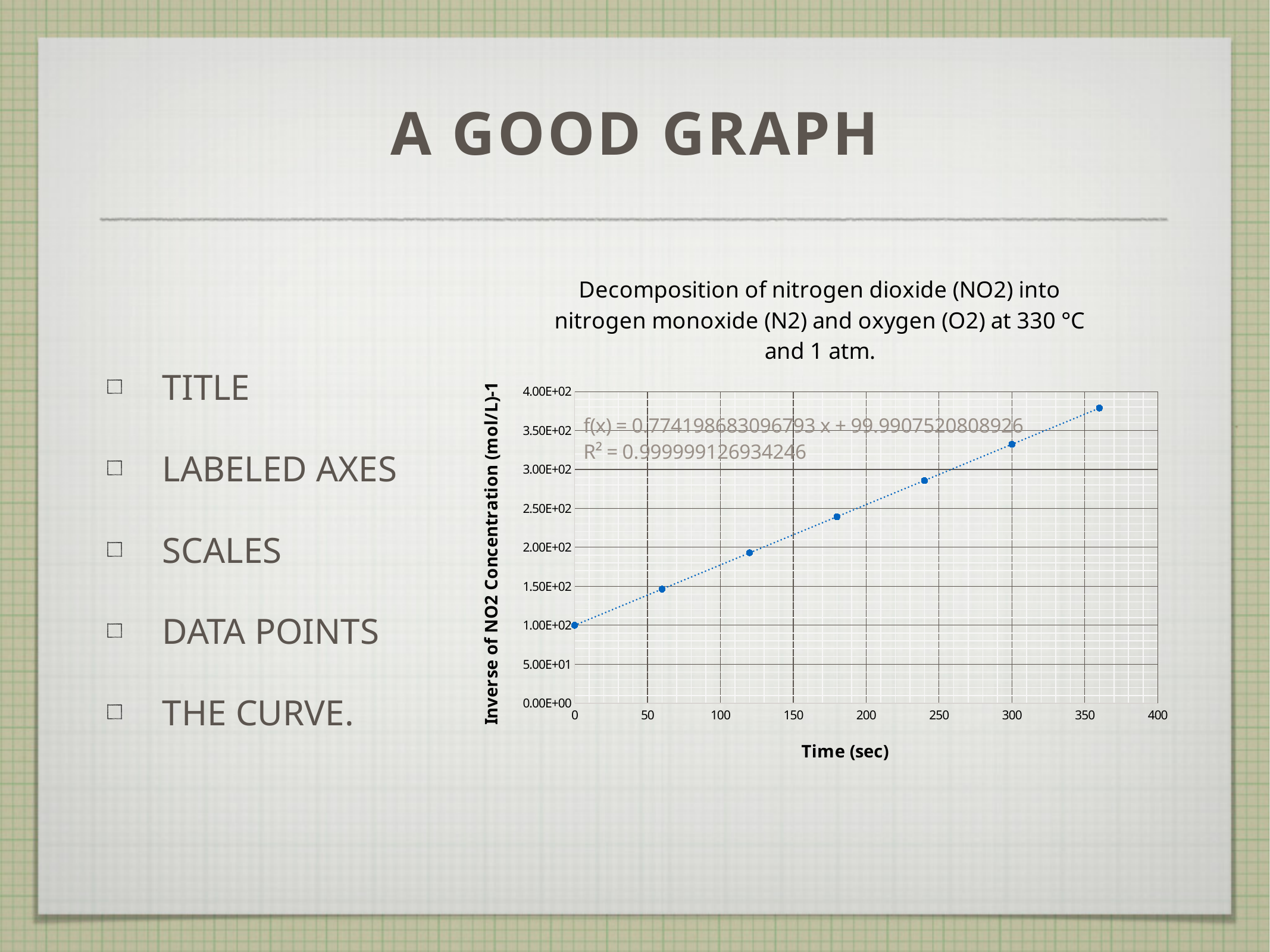
Do the plotted values rise or fall as time increases along the x axis? Rise What is the label of the x axis? Time (sec) Is the value at 360 sec greater or less than 3.50E+02? greater How many data points are plotted on the chart? 7 What R² value is shown for the trendline on the chart? 0.999999126934246 At which time (sec) is the inverse of NO2 concentration lowest? 0 What kind of chart is shown on the slide? Scatter chart Is the value at 180 sec greater or less than 2.50E+02? less Which has the larger inverse NO2 concentration value, the point at 120 sec or the point at 240 sec? 240 sec Is the value at 300 sec greater or less than 3.00E+02? greater At which time (sec) is the inverse of NO2 concentration highest? 360